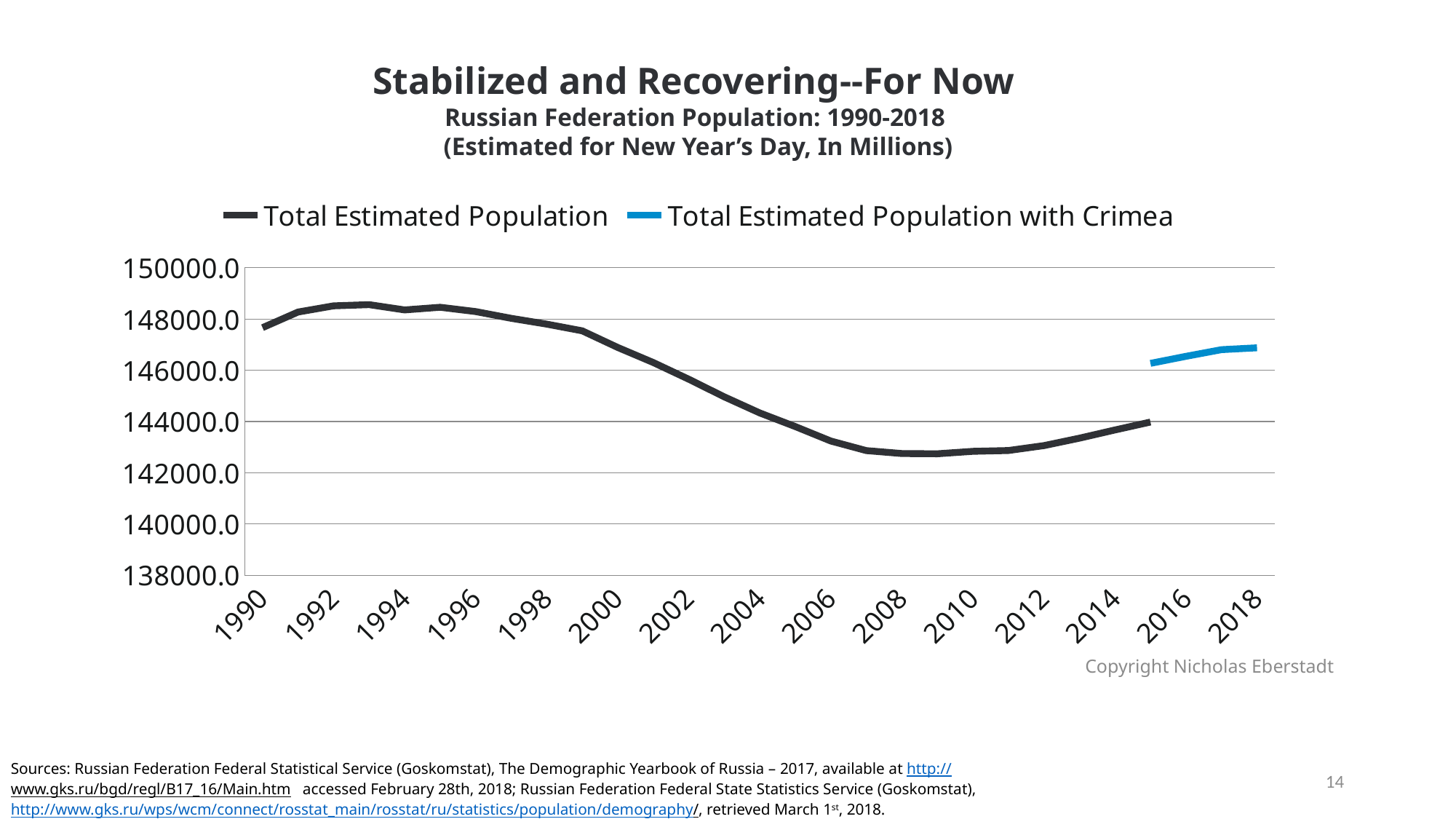
Which is larger, the Total Estimated Population in 1992 or in 2008? 1992 How many series does the legend list? 2 Is the Total Estimated Population value for 2008 greater or less than 144000.0? less Which series is drawn in blue? Total Estimated Population with Crimea Is the Total Estimated Population value for 2012 greater or less than 144000.0? less Is the Total Estimated Population value for 1990 greater or less than 146000.0? greater What kind of chart is shown on the slide? line chart Does the Total Estimated Population with Crimea rise or fall from 2015 to 2018? rise What is the title of the chart? Stabilized and Recovering--For Now Does the Total Estimated Population rise or fall between 1998 and 2008? fall Which is larger, the Total Estimated Population with Crimea in 2018 or the Total Estimated Population in 2014? Total Estimated Population with Crimea in 2018